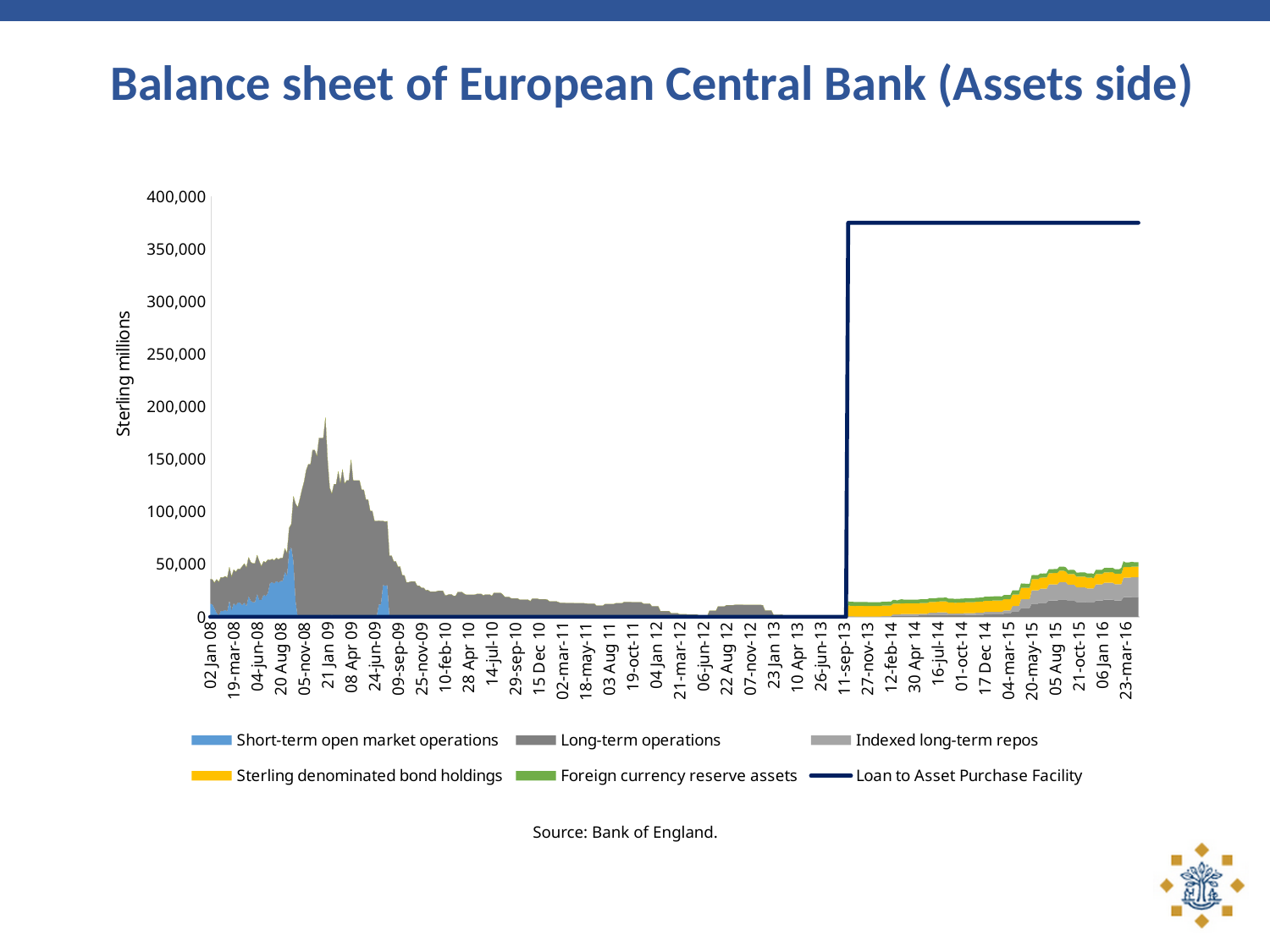
Is the stacked total at 04 Jan 12 greater or less than 50,000? less Which series is drawn as a line rather than a filled area? Loan to Asset Purchase Facility Is the value of Loan to Asset Purchase Facility at 10 Apr 13 greater or less than 50,000? less How many series does the legend list? 6 What is the label on the y axis? Sterling millions Does the Loan to Asset Purchase Facility line rise, fall or stay flat between 11-sep-13 and 23-mar-16? stays flat Is the value of Loan to Asset Purchase Facility at 23-mar-16 greater or less than 350,000? greater Does the stacked total rise or fall between 21 Jan 09 and 04 Jan 12? fall What kind of chart is shown on the slide? area chart Which series reaches the highest value on the chart? Loan to Asset Purchase Facility